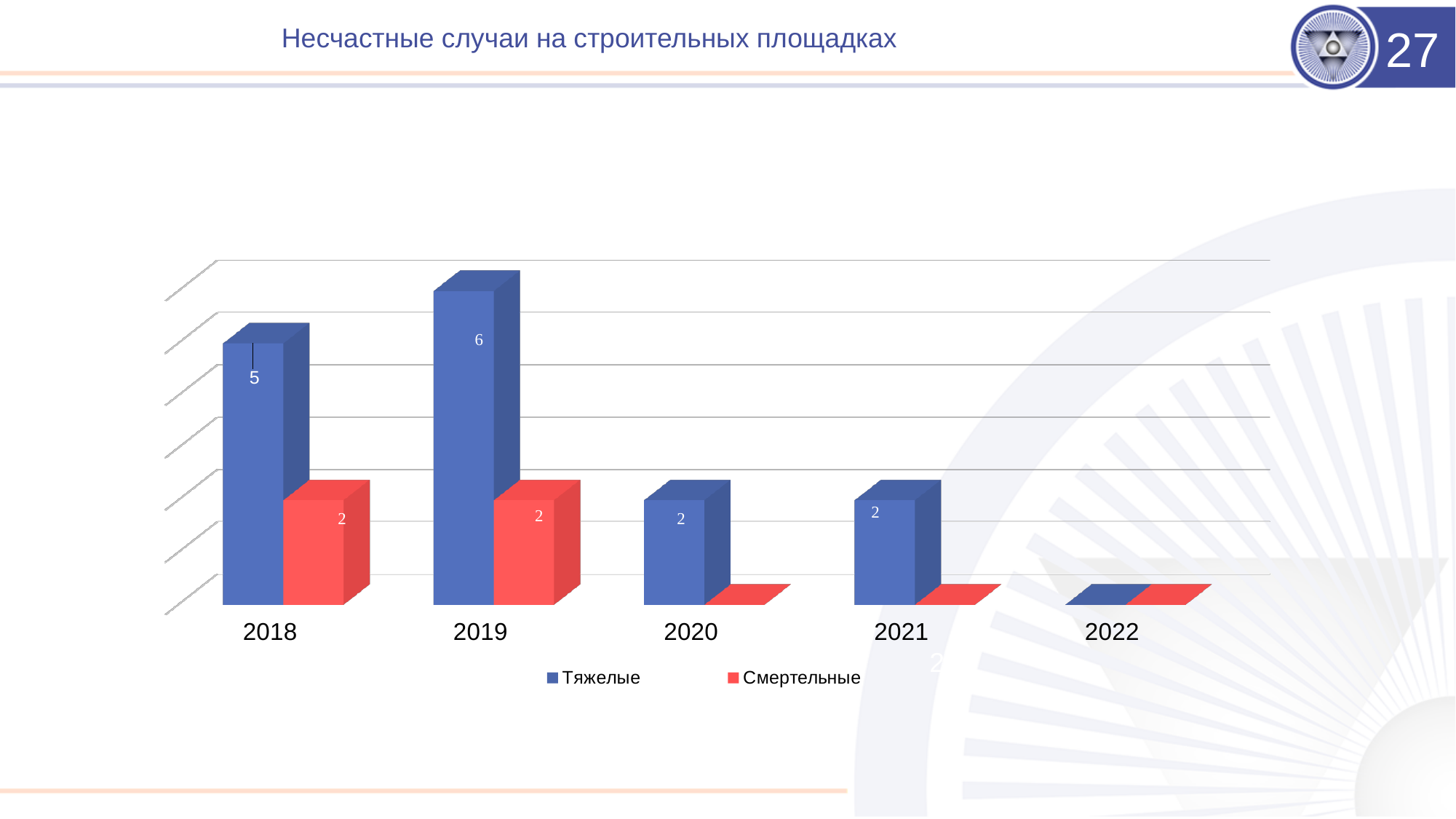
What is the difference between the Тяжелые values for 2019 and 2018? 1 What is the difference between the Тяжелые and Смертельные values in 2018? 3 How many years are shown on the x axis? 5 In which year is the value for Тяжелые the highest? 2019 Does the value for Тяжелые rise or fall from 2019 to 2020? fall What is the value for Тяжелые in 2020? 2 What is the value for Смертельные in 2018? 2 In 2019, which series has the larger value, Тяжелые or Смертельные? Тяжелые How many series does the legend list? 2 What is the value for Тяжелые in 2018? 5 What is the value for Тяжелые in 2019? 6 What kind of chart is shown on the slide? bar chart